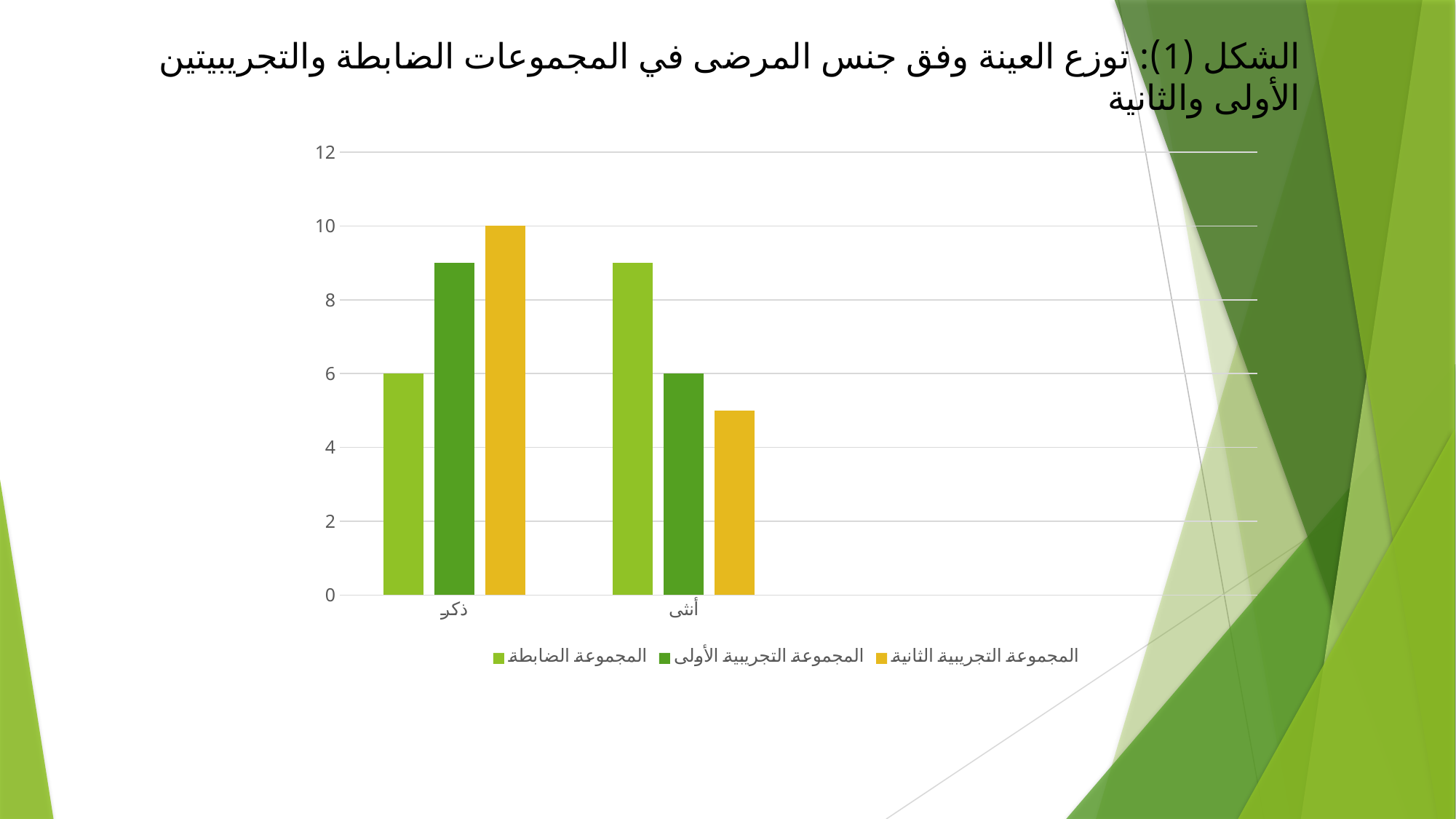
Is the value for المجموعة التجريبية الثانية in the أنثى category greater or less than 6? less How many categories are shown on the x axis? 2 What is the value for المجموعة التجريبية الأولى in the أنثى category? 6 What is the value for المجموعة الضابطة in the ذكر category? 6 Which series has the highest value in the ذكر category? المجموعة التجريبية الثانية Which series has the lowest value in the أنثى category? المجموعة التجريبية الثانية How many series does the legend list? 3 Which is larger: the value for المجموعة الضابطة in ذكر or in أنثى? أنثى What is the value for المجموعة التجريبية الثانية in the ذكر category? 10 Is the value for المجموعة التجريبية الأولى in the ذكر category greater or less than 8? greater Is the value for المجموعة الضابطة in the أنثى category greater or less than 8? greater What kind of chart is shown on the slide? bar chart